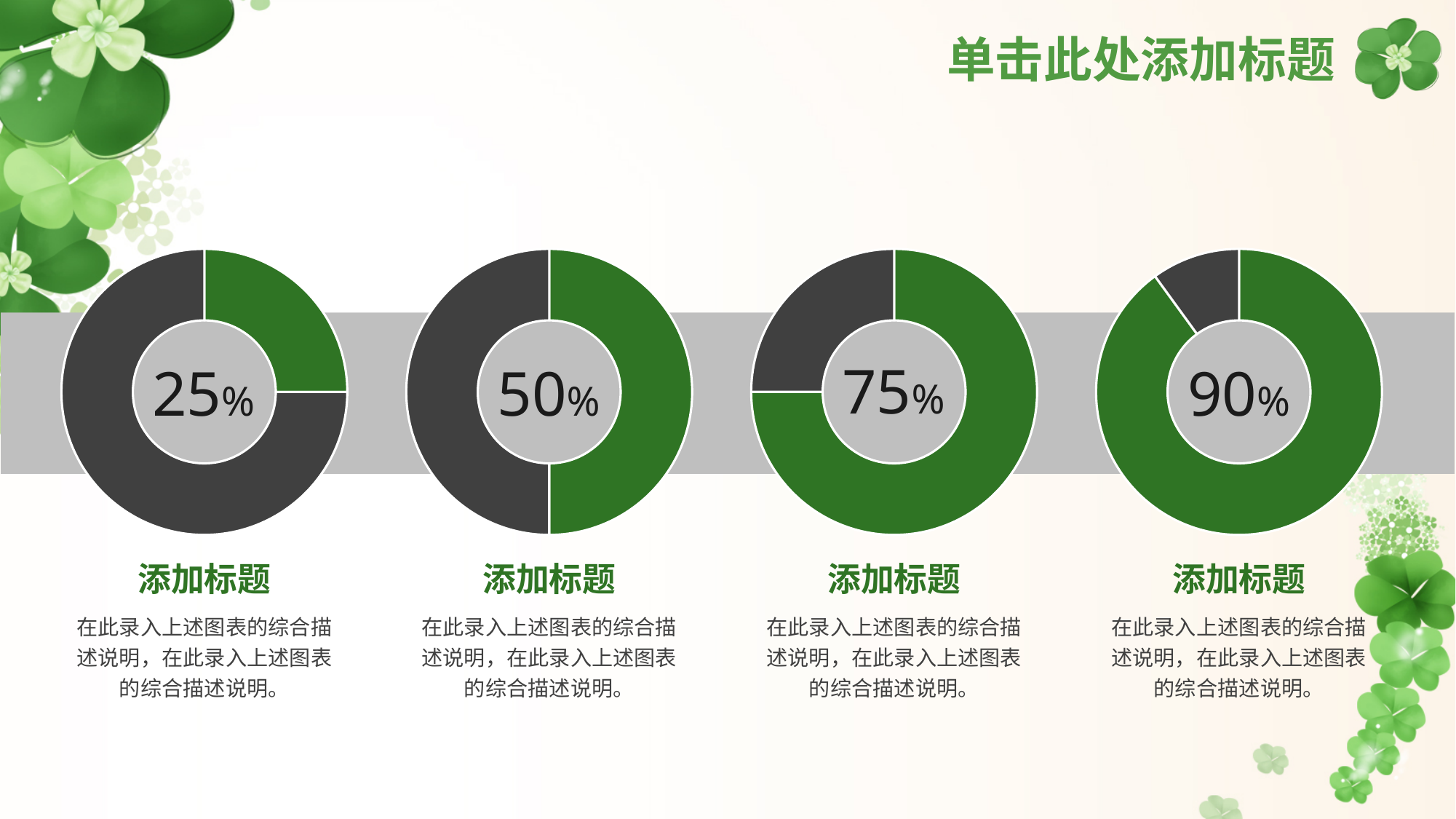
What kind of chart is used for each of the four figures on the slide? Donut chart Which is larger: the percentage in the second donut chart from the left or the percentage in the third donut chart from the left? The third donut chart (75%) What percentage is shown in the centre of the rightmost donut chart? 90% What percentage is shown in the centre of the leftmost donut chart? 25% Do the percentages in the donut charts rise or fall from left to right across the slide? Rise Which donut chart on the slide shows the highest percentage? The rightmost one (90%) In the leftmost donut chart, what colour is the segment representing the 25% share? Green What percentage is shown in the centre of the second donut chart from the left? 50% What percentage is shown in the centre of the third donut chart from the left? 75% What is the difference between the percentage in the rightmost donut chart and the percentage in the leftmost donut chart? 65% How many donut charts are on the slide? 4 Which donut chart on the slide shows the lowest percentage? The leftmost one (25%)